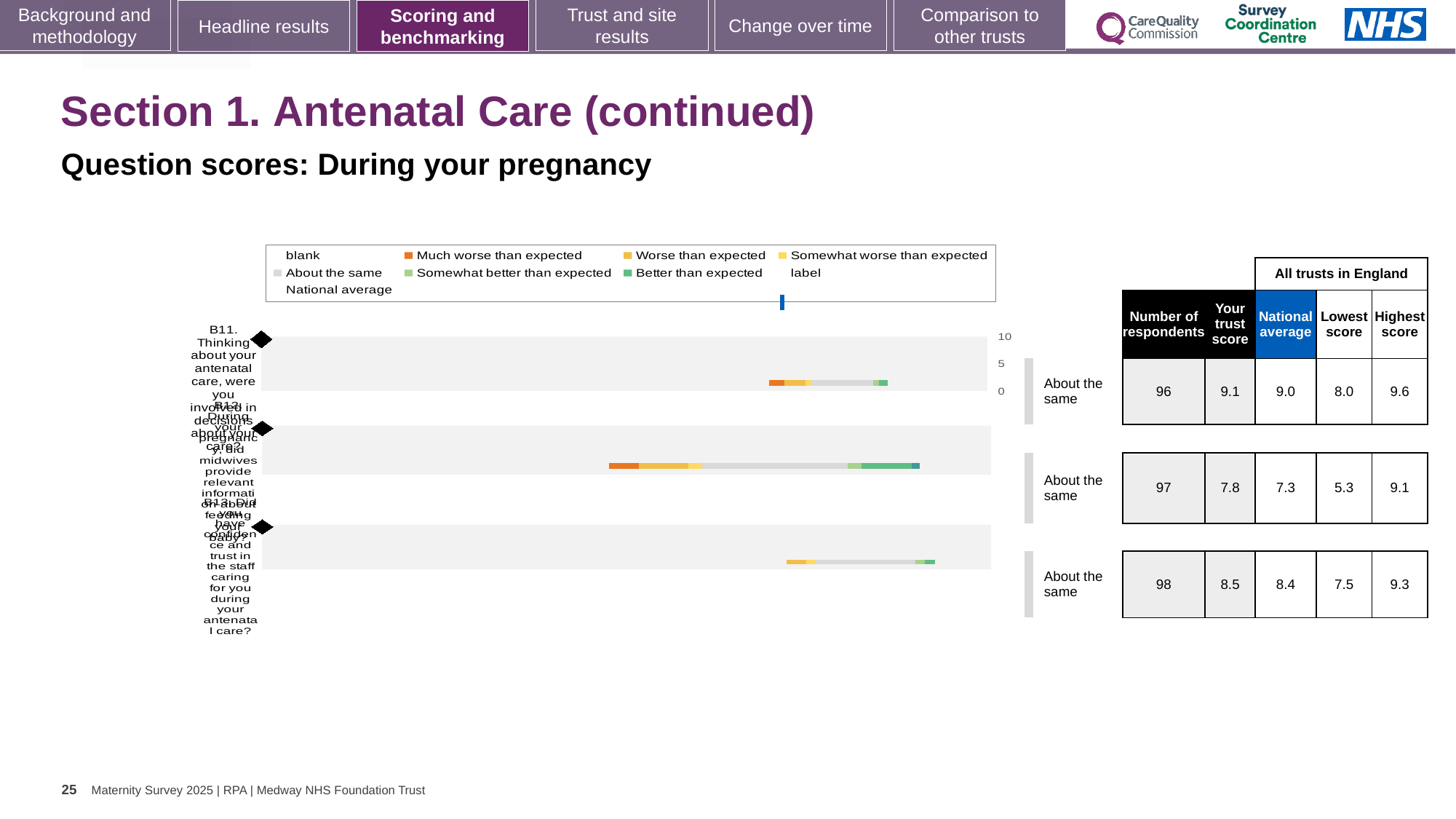
Which question has the highest trust score? B11 How many entries does the chart legend list? 9 What is the national average for question B13? 8.4 Which question has the lowest 'Lowest score' across all trusts in England? B12 What kind of chart is shown on the slide? Bar chart For question B11, which is larger: the trust score or the national average? Trust score What is the difference between the highest score and the lowest score for question B12? 3.8 What benchmark category is shown for all three questions? About the same How many questions (B11, B12, B13) are plotted in the chart? 3 What colour does the legend use for 'Much worse than expected'? Orange What is the number of respondents for question B11? 96 What is the trust score for question B12? 7.8